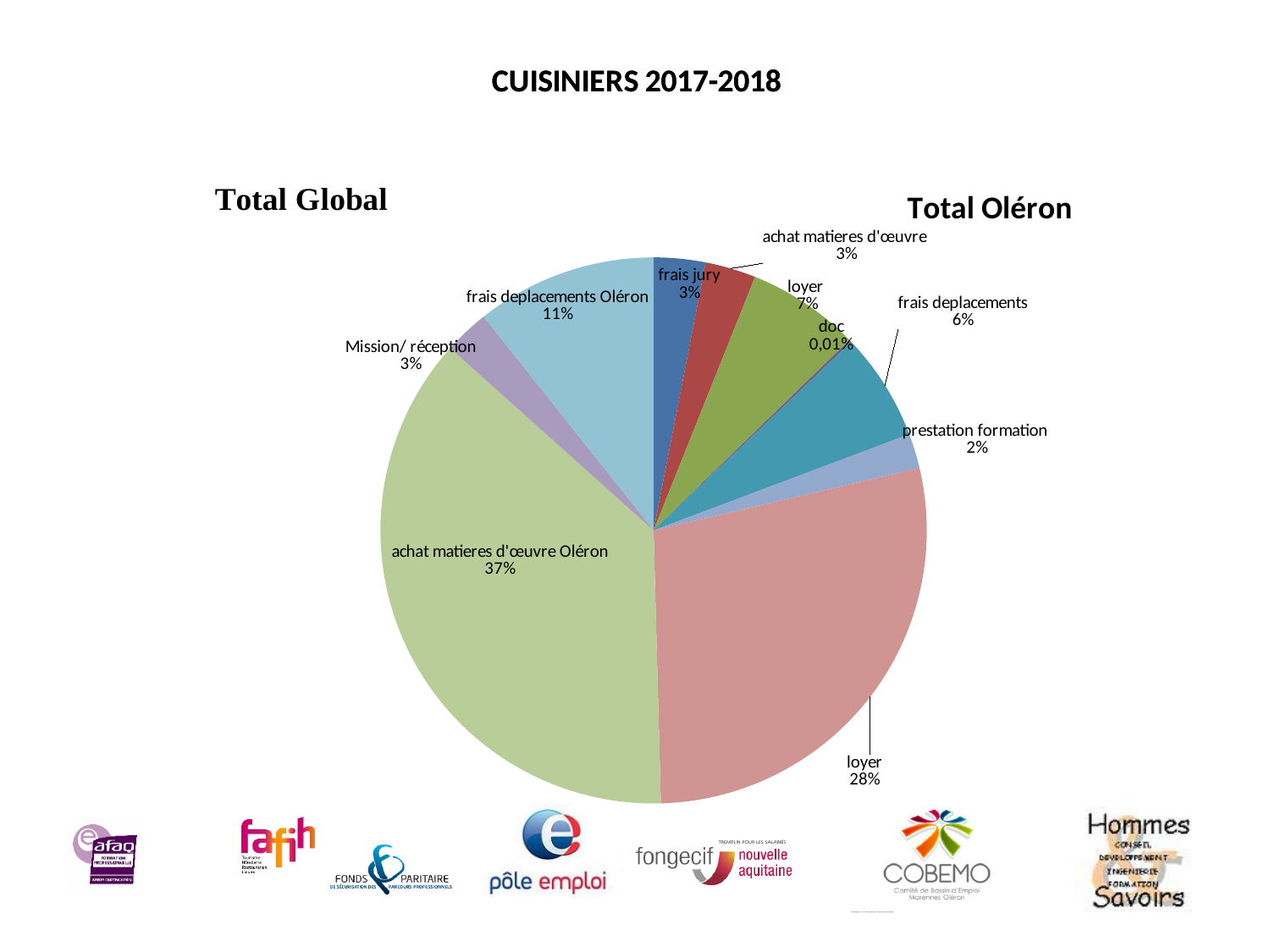
Which slice of the pie is the smallest? doc Which is larger, 'frais deplacements' or 'prestation formation'? frais deplacements What kind of chart is shown on the slide? pie chart Which slice of the pie is the largest? achat matieres d'œuvre Oléron What percentage is shown for 'frais deplacements'? 6% What is the title of the slide's chart? CUISINIERS 2017-2018 What share of the pie is 'achat matieres d'œuvre Oléron'? 37% How many percentage points larger is 'achat matieres d'œuvre Oléron' than 'frais deplacements Oléron'? 26 percentage points What percentage is shown for 'Mission/ réception'? 3% What percentage is shown for 'prestation formation'? 2% What percentage is shown for 'doc'? 0,01% What share of the pie is 'frais deplacements Oléron'? 11%